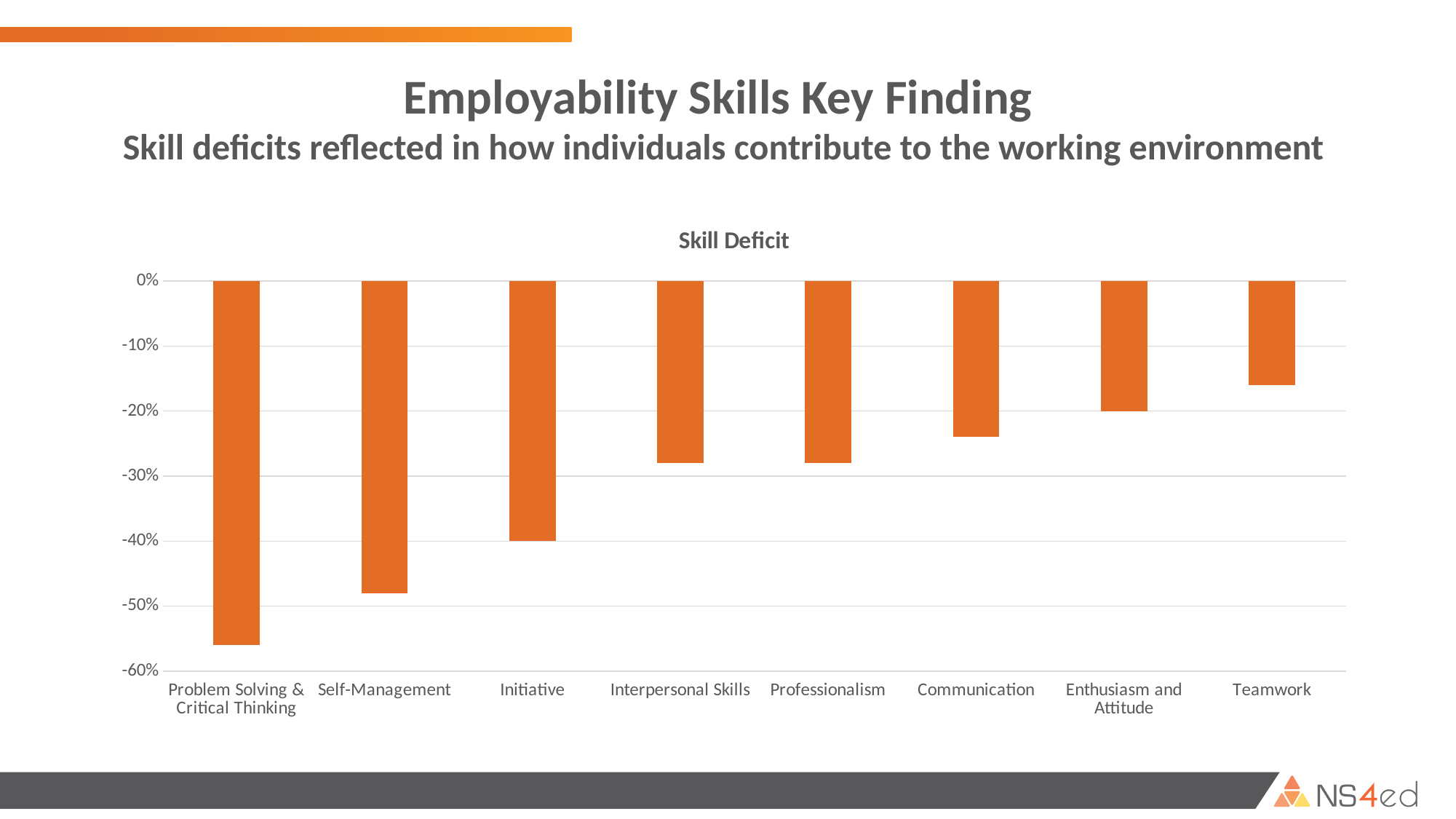
How many categories are shown on the x axis of the chart? 8 Is the value for Problem Solving & Critical Thinking greater or less than -50%? less Which category has the highest (least negative) value? Teamwork Do the values rise or fall moving from left to right along the x axis? rise Which has the lower value, Self-Management or Initiative? Self-Management What is the value for Enthusiasm and Attitude? -20% What is the value for Initiative? -40% What kind of chart is shown on the slide? bar chart Is the value for Communication greater or less than -20%? less Which category has the lowest (most negative) value? Problem Solving & Critical Thinking What is the title of the chart? Skill Deficit Is the value for Teamwork greater or less than -20%? greater